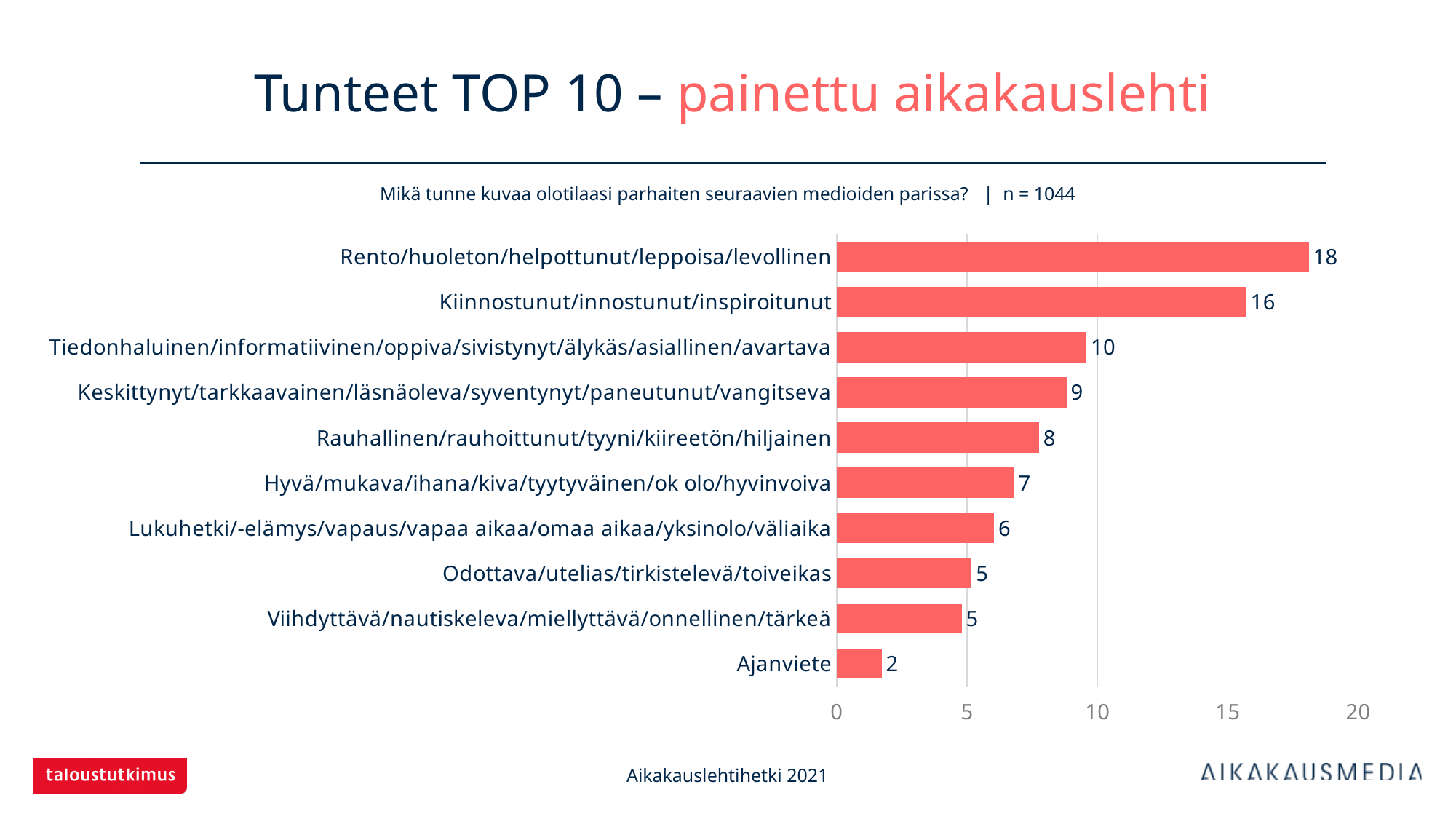
What is the value for Kiinnostunut/innostunut/inspiroitunut? 16 Is the value for Keskittynyt/tarkkaavainen/läsnäoleva/syventynyt/paneutunut/vangitseva greater or less than 5? greater Which is larger, the value for Tiedonhaluinen/informatiivinen/oppiva/sivistynyt/älykäs/asiallinen/avartava or the value for Hyvä/mukava/ihana/kiva/tyytyväinen/ok olo/hyvinvoiva? Tiedonhaluinen/informatiivinen/oppiva/sivistynyt/älykäs/asiallinen/avartava What is the value for Rauhallinen/rauhoittunut/tyyni/kiireetön/hiljainen? 8 Which category has the lowest value? Ajanviete What kind of chart is shown on the slide? Bar chart What is the value for Ajanviete? 2 Which category has the highest value? Rento/huoleton/helpottunut/leppoisa/levollinen How many categories are shown in the chart? 10 What is the sample size (n) stated above the chart? n = 1044 What is the difference between the values for Rento/huoleton/helpottunut/leppoisa/levollinen and Kiinnostunut/innostunut/inspiroitunut? 2 What is the value for Rento/huoleton/helpottunut/leppoisa/levollinen? 18